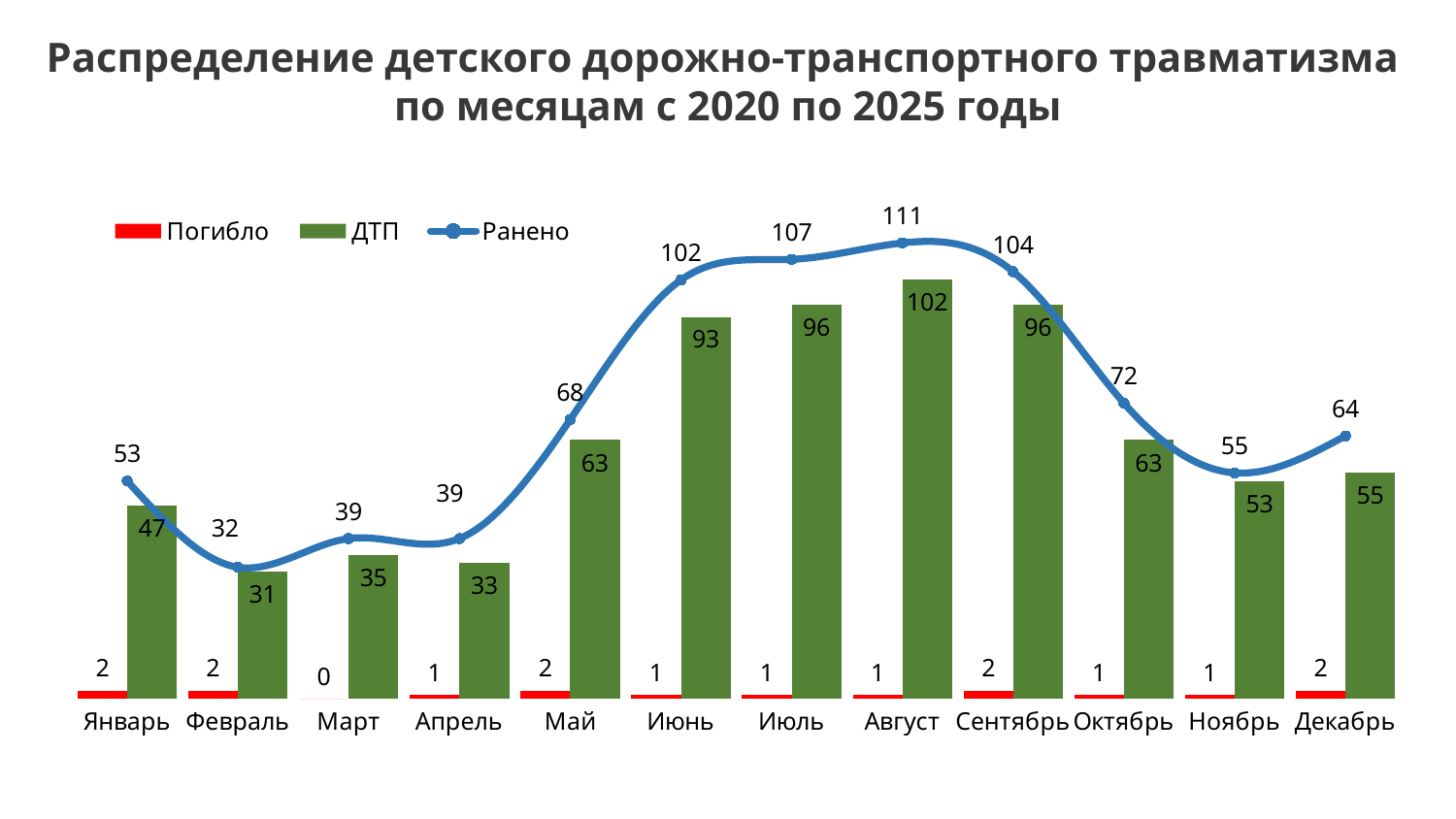
What is the Ранено value for Июль? 107 How many series does the legend list? 3 Which month has the highest Ранено value? Август What is the Погибло value for Март? 0 How many months are shown on the x axis? 12 What kind of chart is this? Combined bar and line chart Which month has the lowest ДТП value? Февраль Which is larger, the Ранено value for Октябрь or for Декабрь? Октябрь What is the difference between the ДТП values for Июнь and Январь? 46 What is the ДТП value for Август? 102 Which series is shown in red? Погибло Does the Ранено line rise or fall from Май to Август? Rises